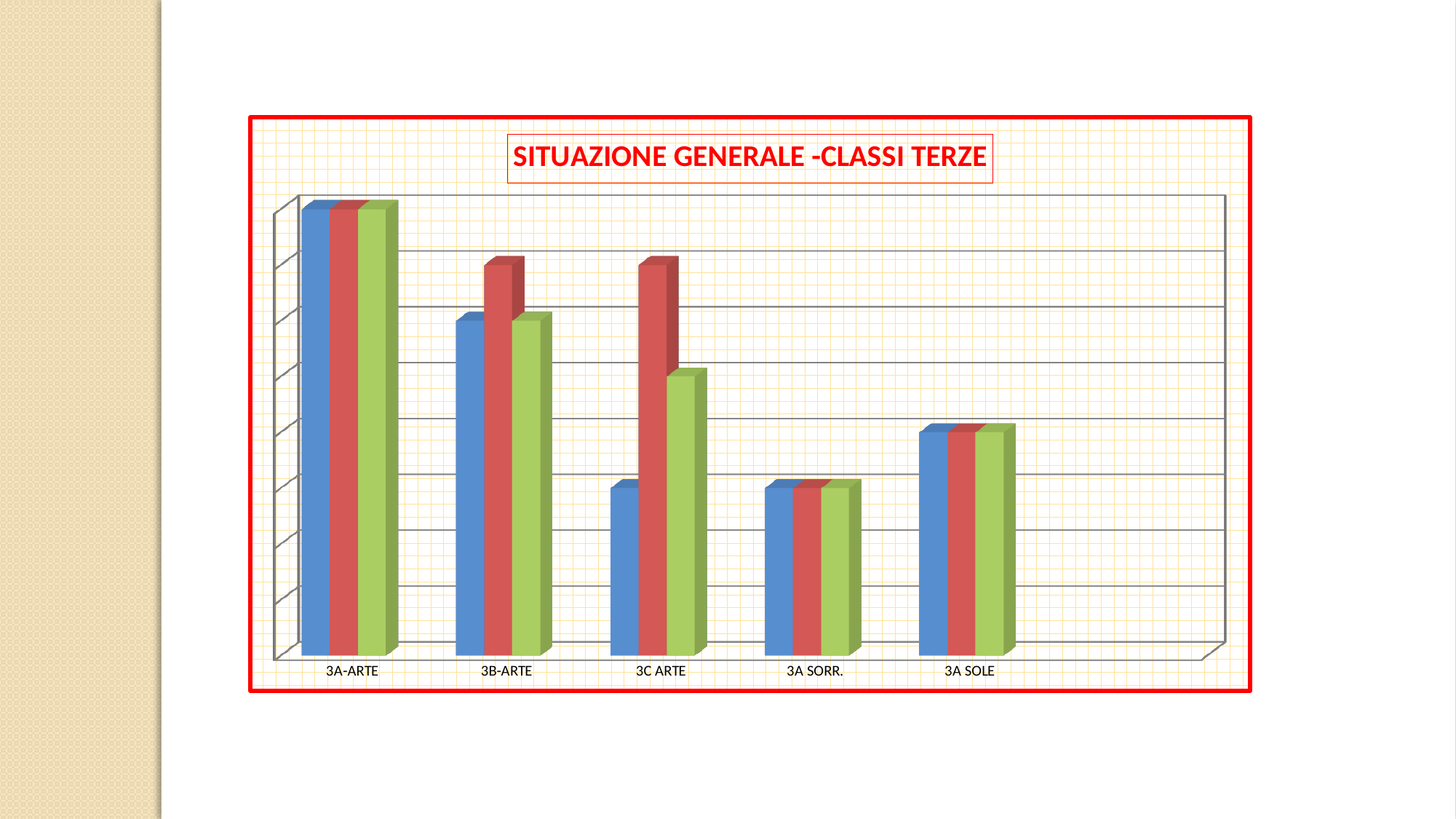
Within the 3B-ARTE category, which coloured bar is the tallest? Red How many categories are shown on the x axis of the chart? 5 What colours are the three bars in each category of the chart? Blue, red and green Within the 3C ARTE category, which coloured bar is the tallest? Red Which category has the tallest bars in the chart? 3A-ARTE Which category has the shortest bars overall in the chart? 3A SORR. Is the blue bar for 3A SOLE taller or shorter than the blue bar for 3A SORR.? Taller What kind of chart is shown on the slide? Bar chart Is the green bar for 3B-ARTE taller or shorter than the green bar for 3C ARTE? Taller Within the 3C ARTE category, which coloured bar is the shortest? Blue What is the title of the chart? SITUAZIONE GENERALE -CLASSI TERZE How many bars are plotted for each category in the chart? 3